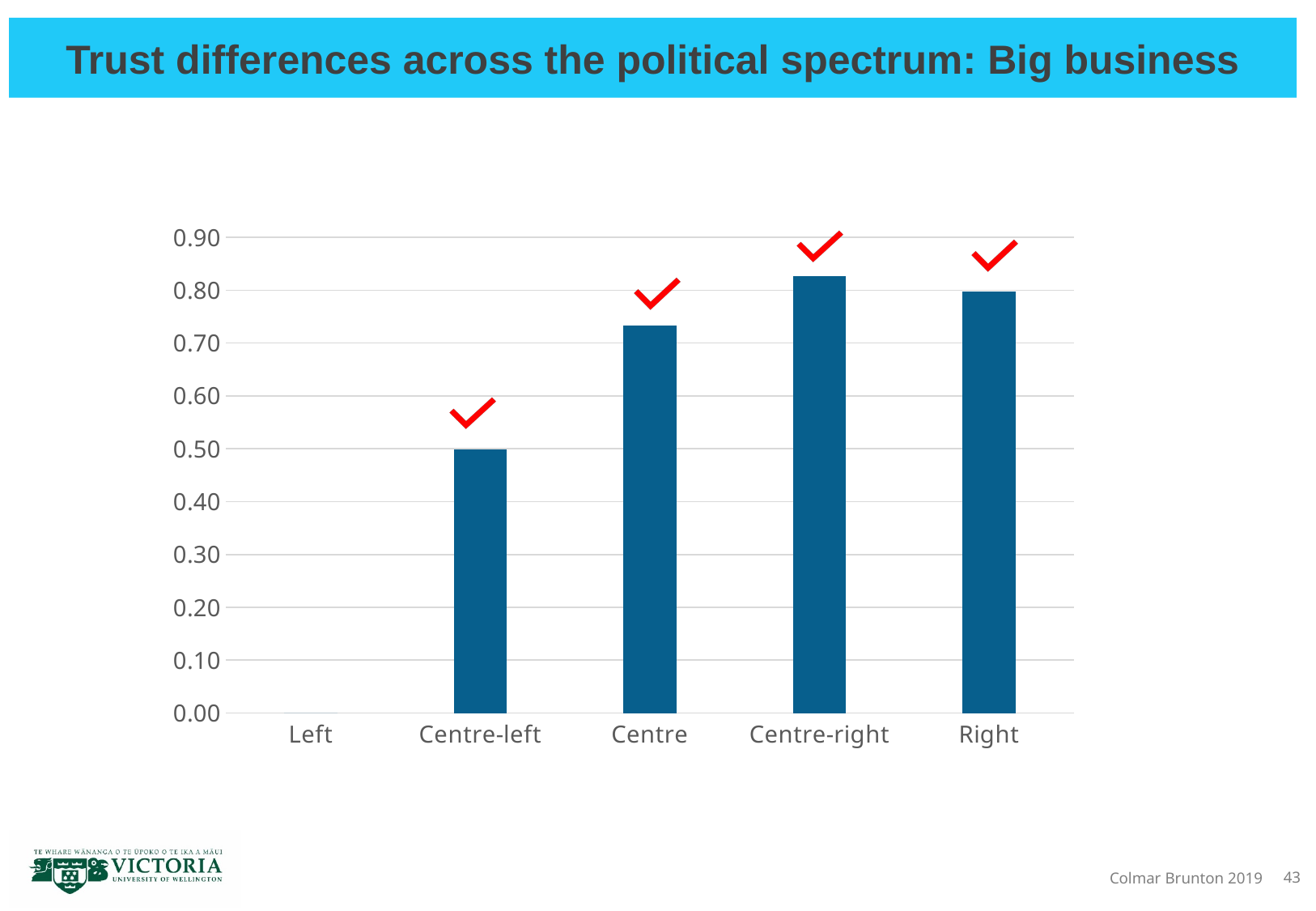
Which category has the lowest value? Left Do the values generally rise or fall moving from Left to Centre-right along the x axis? rise How many political categories are shown on the x axis? 5 Is the value for Centre greater or less than 0.80? less What is the value for Left? 0.00 Is the value for Centre-right greater or less than 0.80? greater Which category has the highest value? Centre-right What is the title of the slide containing the chart? Trust differences across the political spectrum: Big business What kind of chart is shown on the slide? Bar chart Which is larger, the value for Centre or the value for Right? Right Is the value for Centre greater or less than 0.70? greater